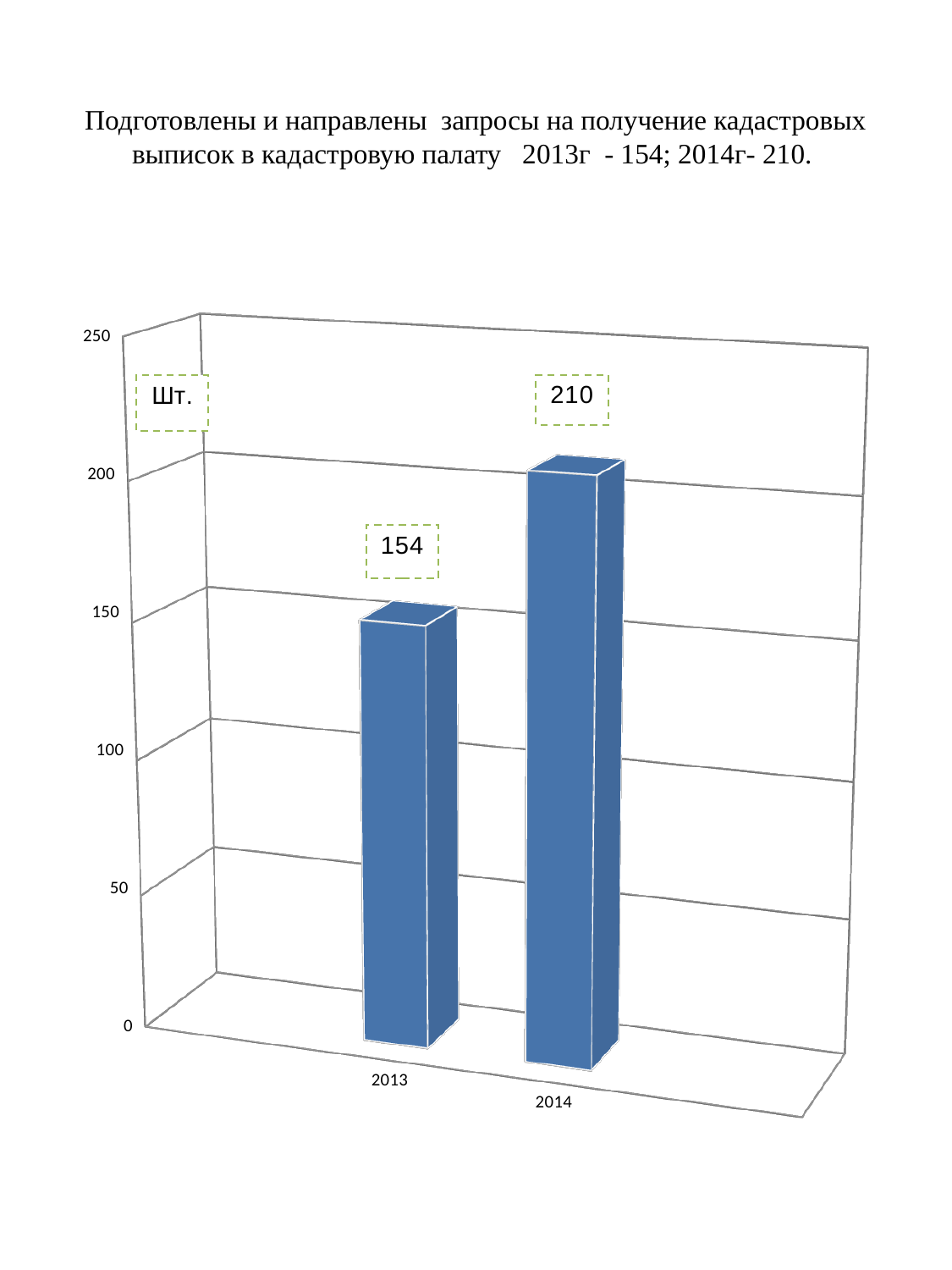
How many categories are shown on the x axis? 2 What is the difference between the values for 2014 and 2013? 56 Which year has the highest value? 2014 What is the value for 2013? 154 What unit label is shown in the box at the top left of the chart? Шт. Which year has the lowest value? 2013 Which is larger, the value for 2013 or the value for 2014? 2014 Is the value for 2013 greater or less than 150? greater Do the values rise or fall from 2013 to 2014? rise What kind of chart is shown on the slide? bar chart What is the value for 2014? 210 Is the value for 2014 greater or less than 200? greater